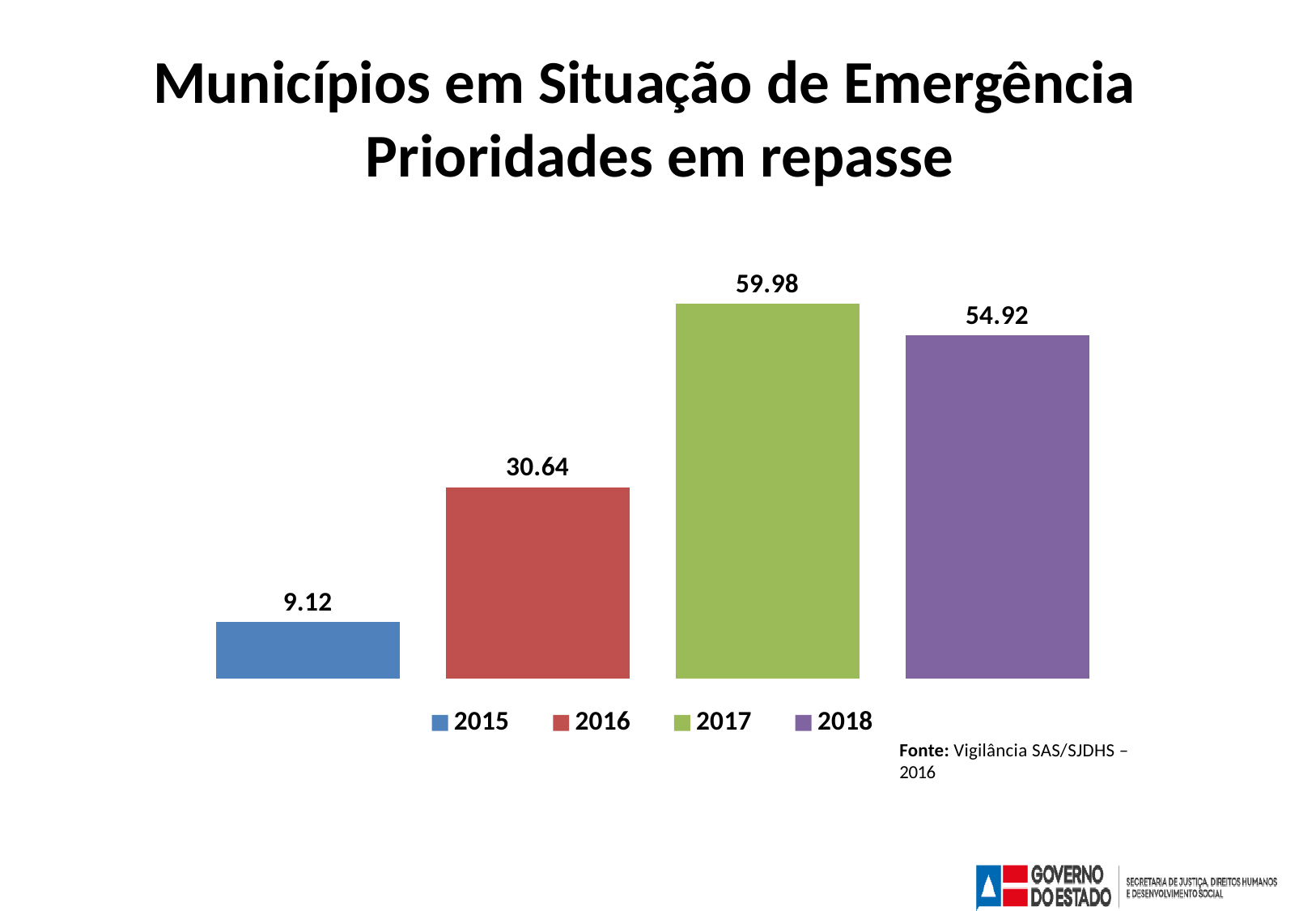
What is the difference between the values for 2016 and 2015? 21.52 What is the value for 2016? 30.64 What kind of chart is shown on the slide? bar chart What is the difference between the values for 2017 and 2018? 5.06 What is the value for 2017? 59.98 How many entries does the legend list? 4 How many years are shown in the chart? 4 Which is larger, the value for 2016 or the value for 2018? 2018 Which year has the lowest value? 2015 What is the value for 2018? 54.92 What is the value for 2015? 9.12 Which year has the highest value? 2017